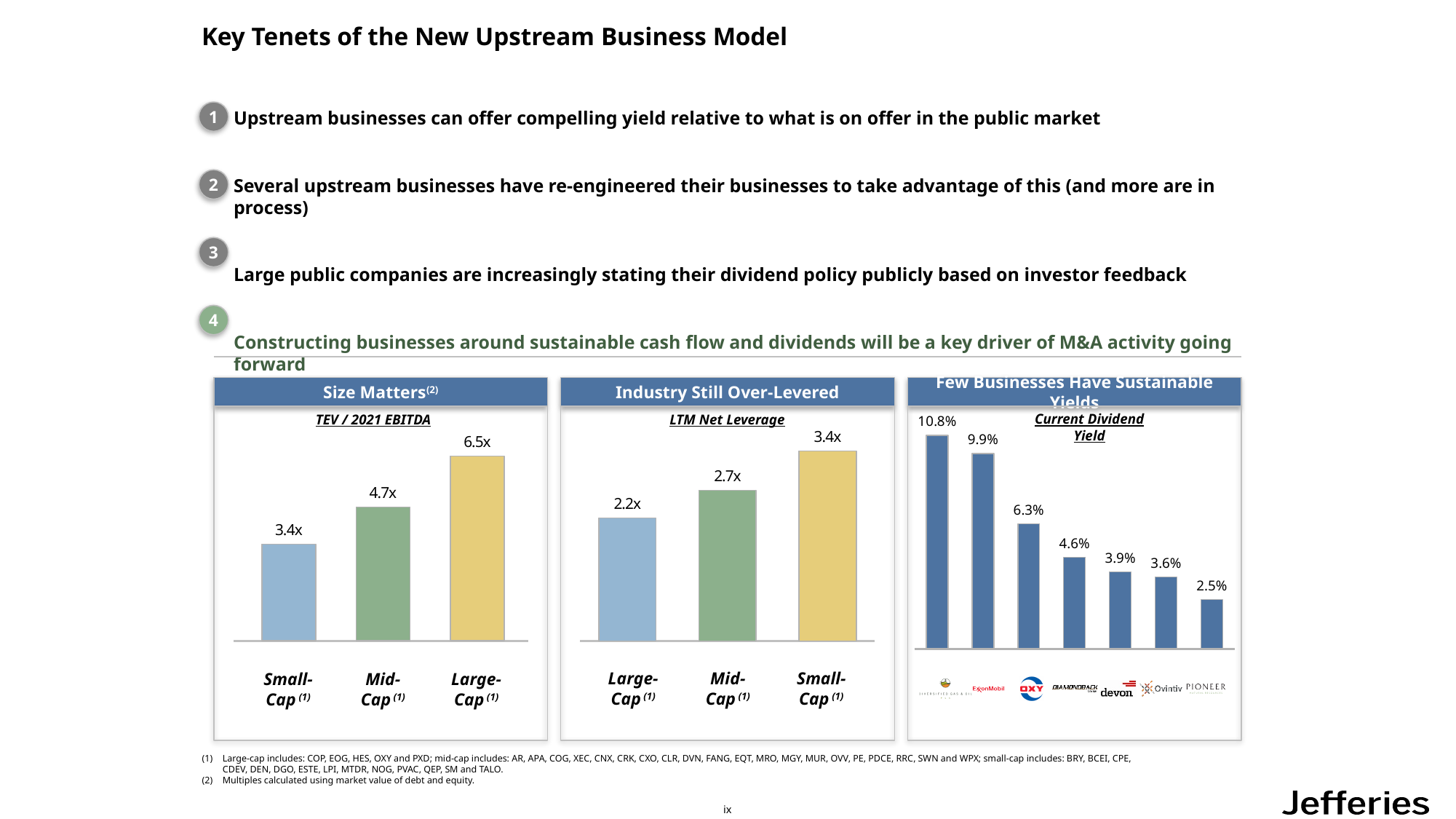
In the Few Businesses Have Sustainable Yields chart, what is the lowest Current Dividend Yield shown? 2.5% In the Size Matters chart, which category has the highest TEV / 2021 EBITDA multiple? Large-Cap In the Industry Still Over-Levered chart, do the values rise or fall from left to right? rise In the Size Matters chart, what is the TEV / 2021 EBITDA multiple for Large-Cap? 6.5x In the Few Businesses Have Sustainable Yields chart, what is the highest Current Dividend Yield shown? 10.8% What type of chart is the Size Matters chart? bar chart In the Size Matters chart, what is the difference between the Large-Cap and Small-Cap multiples? 3.1x In the Industry Still Over-Levered chart, which category has the lowest LTM Net Leverage? Large-Cap In the Industry Still Over-Levered chart, what is the LTM Net Leverage for Mid-Cap? 2.7x In the Industry Still Over-Levered chart, is the LTM Net Leverage larger for Small-Cap or Large-Cap? Small-Cap In the Size Matters chart, what is the value for Small-Cap? 3.4x In the Few Businesses Have Sustainable Yields chart, how many bars are plotted? 7